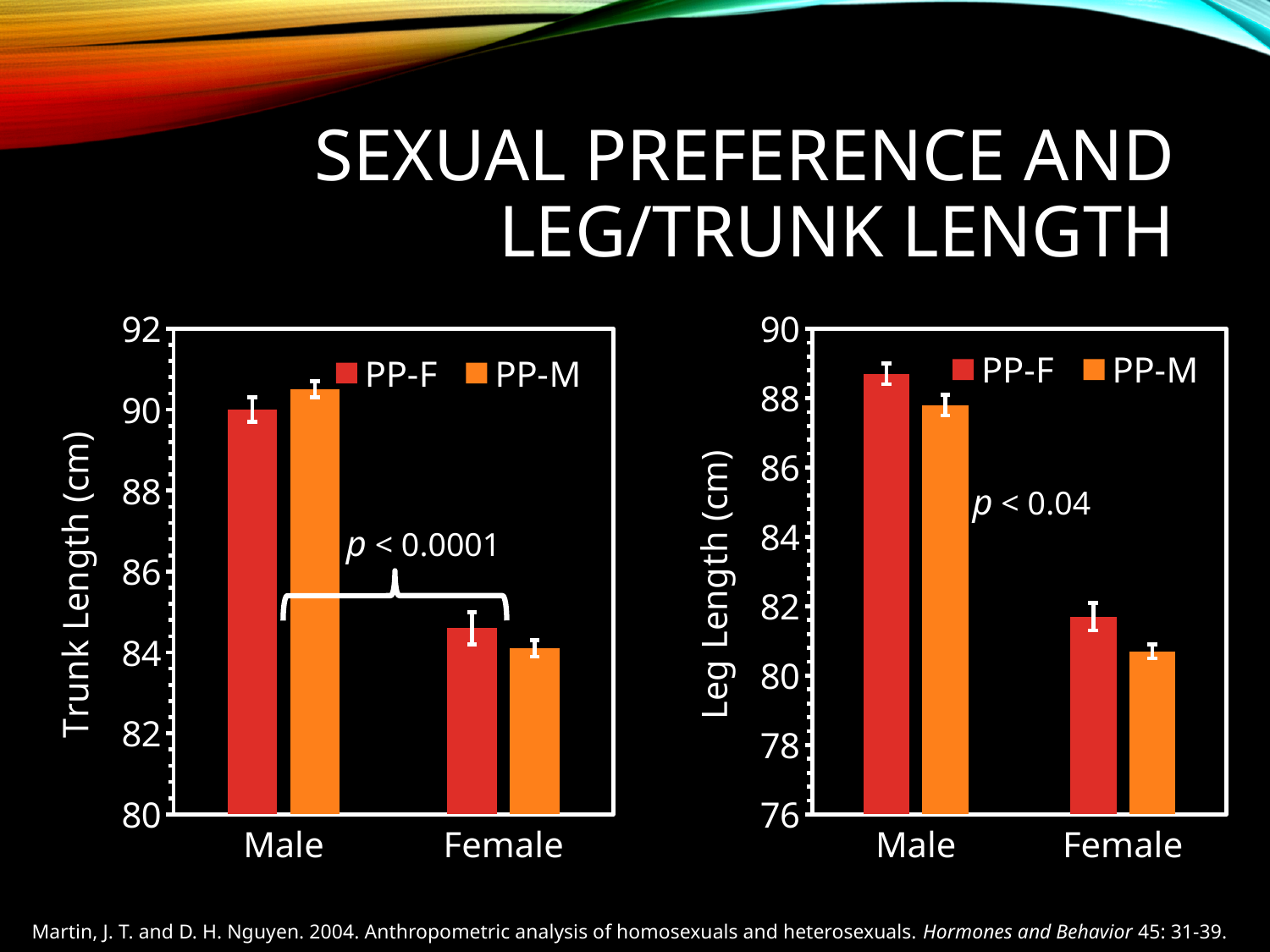
How many categories are shown on the x axis of the Trunk Length chart on the left? 2 In the Trunk Length chart on the left, is the value for Female PP-F greater or less than 84? greater How many series does the legend of the Leg Length chart on the right list? 2 What kind of chart is the Trunk Length chart on the left? bar chart In the Leg Length chart on the right, is the value for Male PP-F greater or less than 88? greater In the Leg Length chart on the right, is the value for Female PP-M greater or less than 80? greater What is the y-axis title of the chart on the right? Leg Length (cm) In the Leg Length chart on the right, which bar is the highest? Male PP-F In the Leg Length chart on the right, which bar is the lowest? Female PP-M In the Leg Length chart on the right, which is larger for Male: PP-F or PP-M? PP-F In the Trunk Length chart on the left, which is larger for PP-F: Male or Female? Male